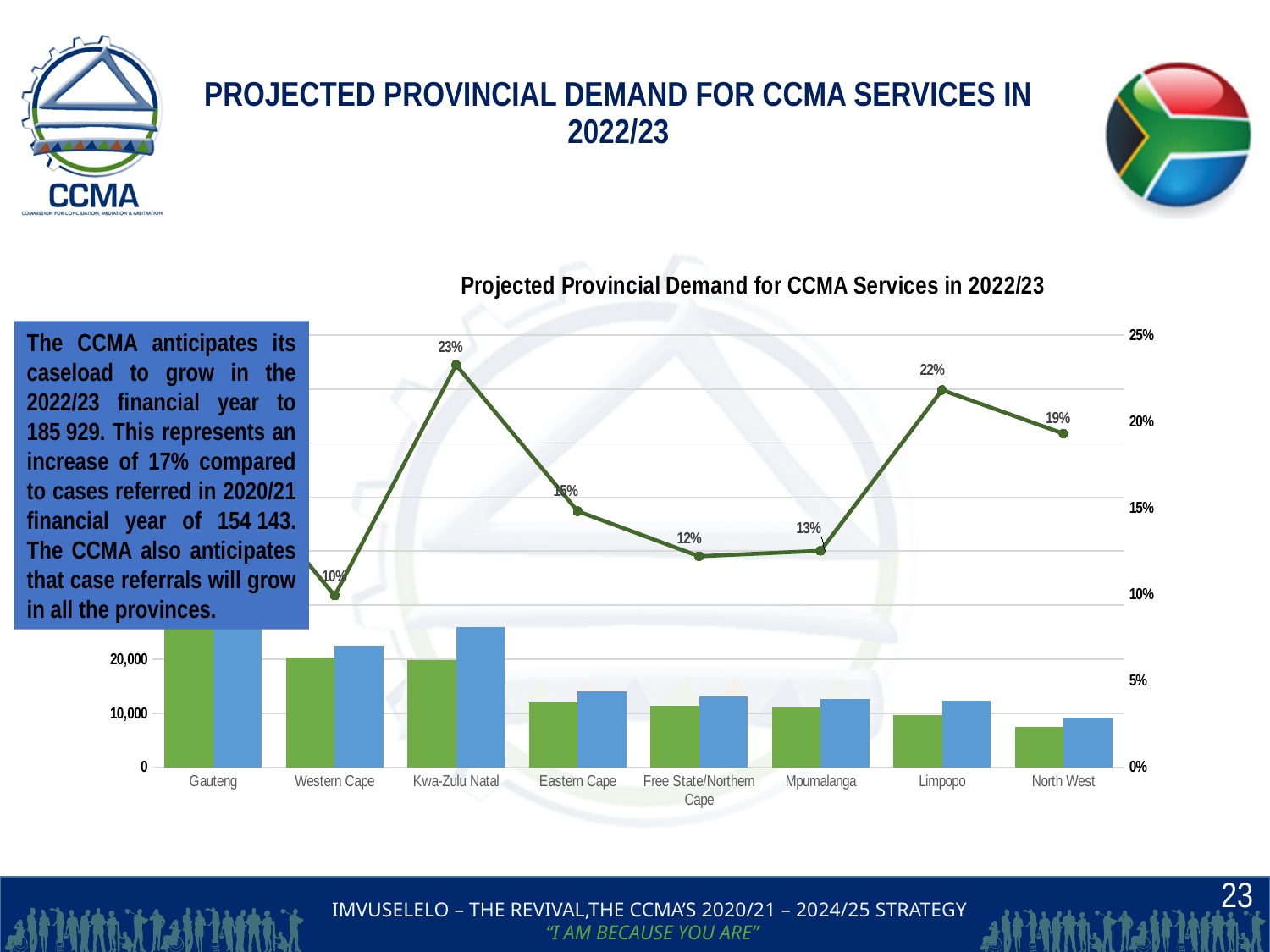
Which province has the highest percentage on the line? Kwa-Zulu Natal What percentage does the line show for Kwa-Zulu Natal? 23% What is the difference between the line percentages for Limpopo and North West? 3% What kind of chart is shown on the slide? A combined bar and line chart What percentage does the line show for Free State/Northern Cape? 12% Is the blue bar for North West greater or less than 10,000? less How many provinces are shown on the x axis of the chart? 8 Which province has the lowest labelled percentage on the line? Western Cape Is the line percentage for Mpumalanga larger than that for Free State/Northern Cape? Yes, Mpumalanga (13%) is larger What percentage does the line show for North West? 19% What percentage does the line show for Limpopo? 22% What is the chart's title? Projected Provincial Demand for CCMA Services in 2022/23